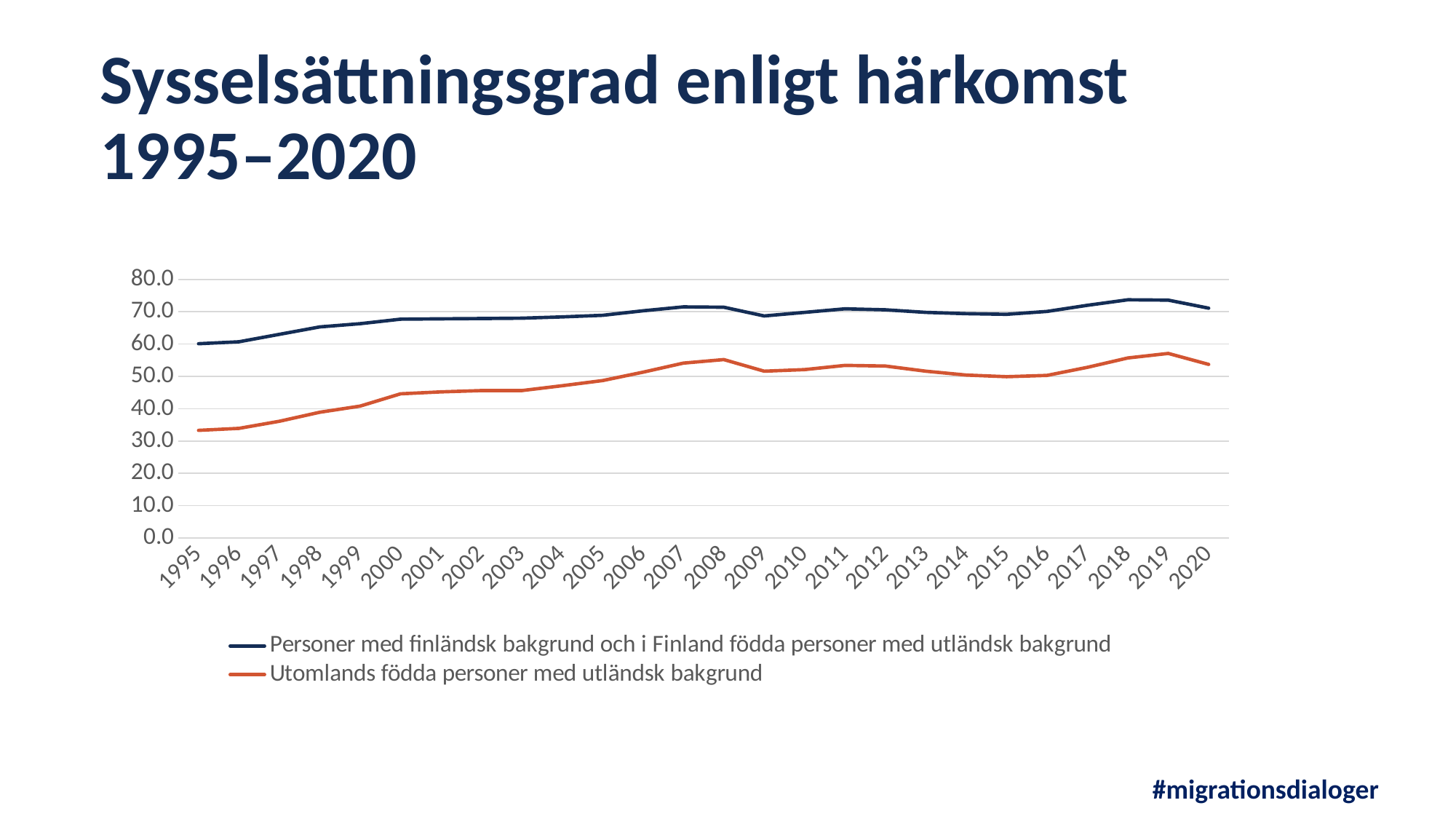
How many years are plotted along the x axis? 26 Is the value for 'Personer med finländsk bakgrund och i Finland födda personer med utländsk bakgrund' in 2009 greater or less than 70? less What kind of chart is shown on the slide? line chart Which series has the higher value in 2010? Personer med finländsk bakgrund och i Finland födda personer med utländsk bakgrund In which year is the value for 'Utomlands födda personer med utländsk bakgrund' highest? 2019 How many series does the legend list? 2 In which year is the value for 'Utomlands födda personer med utländsk bakgrund' lowest? 1995 What colour is the line for 'Utomlands födda personer med utländsk bakgrund'? orange Does the value for 'Utomlands födda personer med utländsk bakgrund' rise or fall overall from 1995 to 2020? rise Is the value for 'Personer med finländsk bakgrund och i Finland födda personer med utländsk bakgrund' in 2018 greater or less than 70? greater Is the value for 'Utomlands födda personer med utländsk bakgrund' in 2019 greater or less than 50? greater